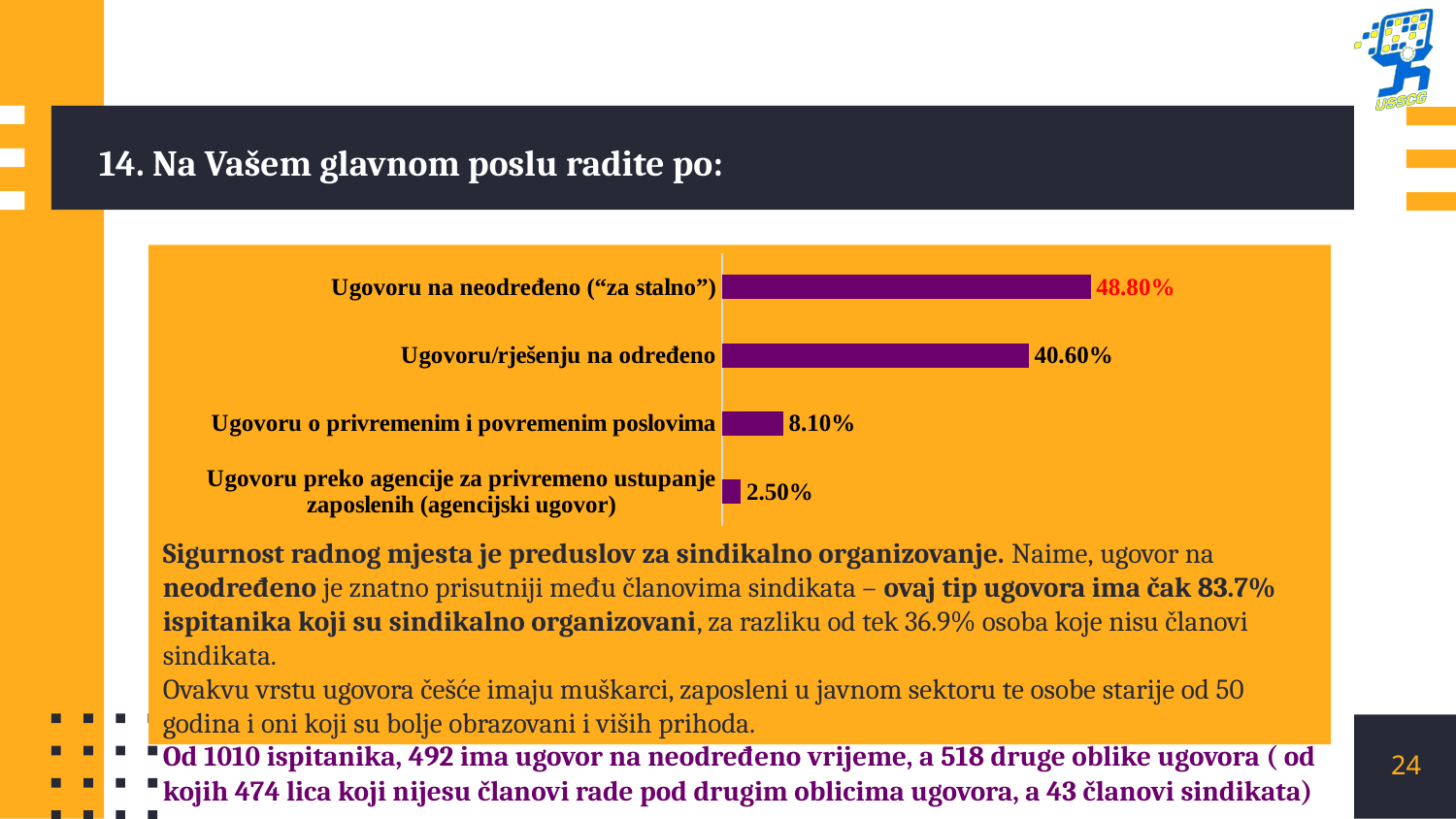
What is the value for "Ugovoru na neodređeno ("za stalno")"? 48.80% What is the difference between the values for "Ugovoru na neodređeno ("za stalno")" and "Ugovoru/rješenju na određeno"? 8.20% What is the title of the slide containing the chart? 14. Na Vašem glavnom poslu radite po: What is the difference between the values for "Ugovoru o privremenim i povremenim poslovima" and "Ugovoru preko agencije za privremeno ustupanje zaposlenih (agencijski ugovor)"? 5.60% What is the value for "Ugovoru/rješenju na određeno"? 40.60% Which is larger, the value for "Ugovoru/rješenju na određeno" or for "Ugovoru o privremenim i povremenim poslovima"? Ugovoru/rješenju na određeno What is the value for "Ugovoru preko agencije za privremeno ustupanje zaposlenih (agencijski ugovor)"? 2.50% What kind of chart is shown on the slide? Bar chart How many categories are shown in the chart? 4 Which category has the highest value? Ugovoru na neodređeno ("za stalno") What is the value for "Ugovoru o privremenim i povremenim poslovima"? 8.10% Which category has the lowest value? Ugovoru preko agencije za privremeno ustupanje zaposlenih (agencijski ugovor)